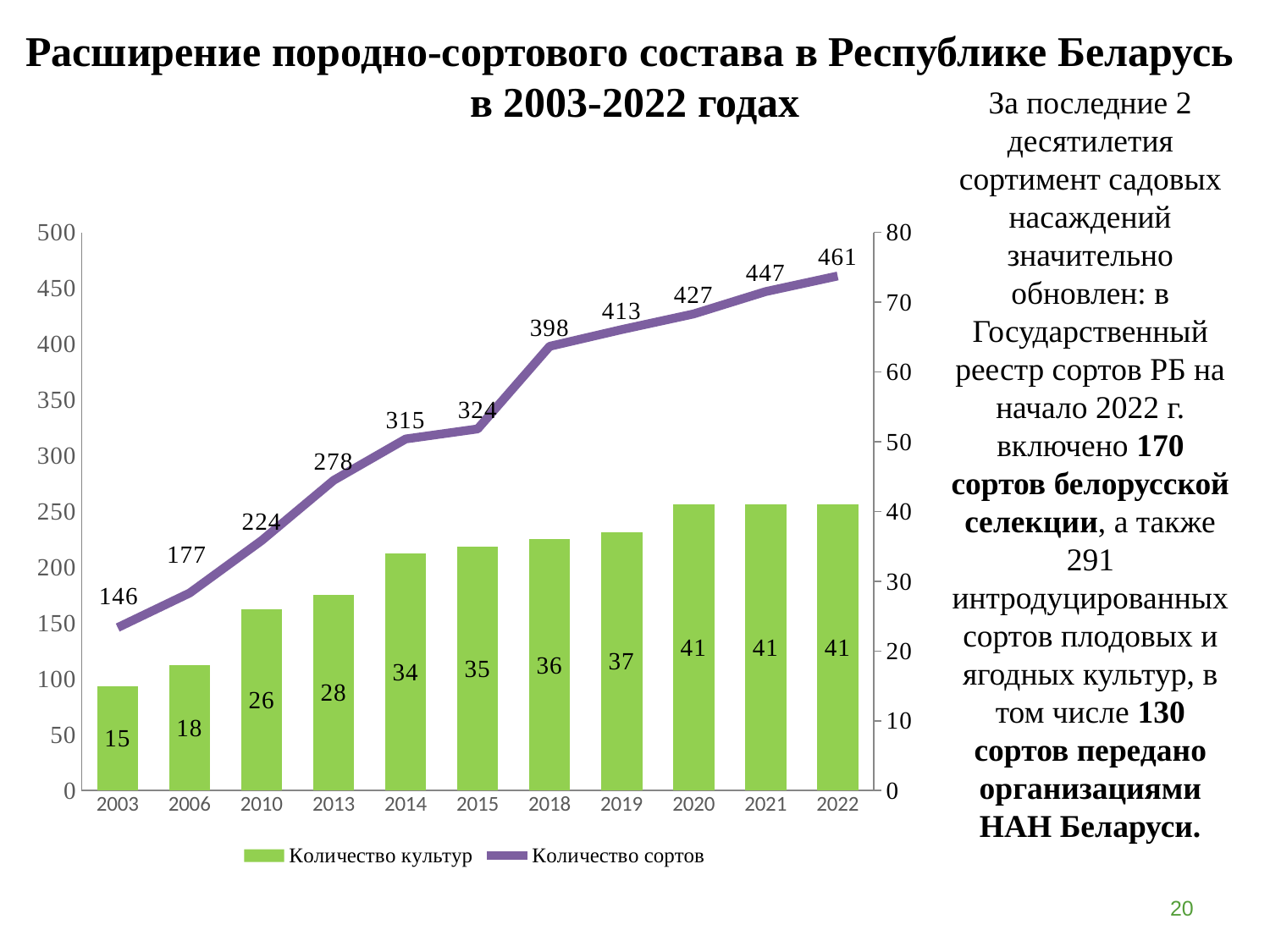
Does Количество сортов rise or fall from 2003 to 2022? rise What is the value of Количество культур in 2014? 34 What is the difference between Количество сортов in 2022 and in 2003? 315 How many years are shown on the x axis? 11 What is the value of Количество сортов in 2022? 461 Which is larger, Количество сортов in 2015 or in 2014? 2015 How many series does the legend list? 2 What is the value of Количество сортов in 2018? 398 What is the value of Количество культур in 2003? 15 Which series is drawn as a line? Количество сортов In which year is Количество сортов lowest? 2003 What is the difference between Количество культур in 2013 and in 2010? 2